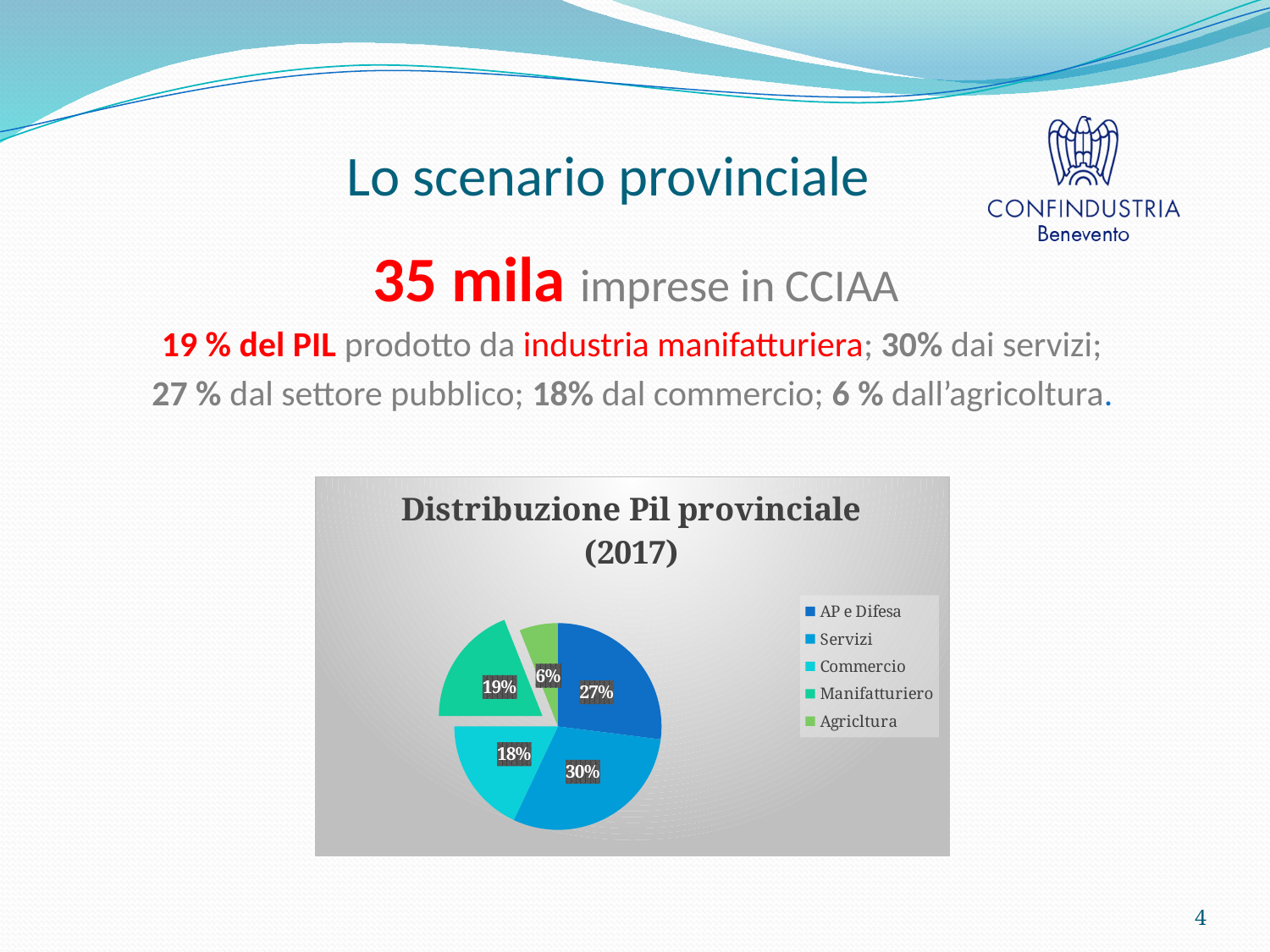
What share of the pie is Servizi? 30% How many entries does the legend list? 5 Which category has the largest slice of the pie? Servizi Which category has the smallest slice of the pie? Agricltura What kind of chart is shown on the slide? pie chart What share of the pie is Manifatturiero? 19% What is the title of the chart? Distribuzione Pil provinciale (2017) What is the difference in percentage points between Servizi and Agricltura? 24 Which is larger, the share for AP e Difesa or the share for Commercio? AP e Difesa How many slices does the pie chart have? 5 What share of the pie is Commercio? 18%